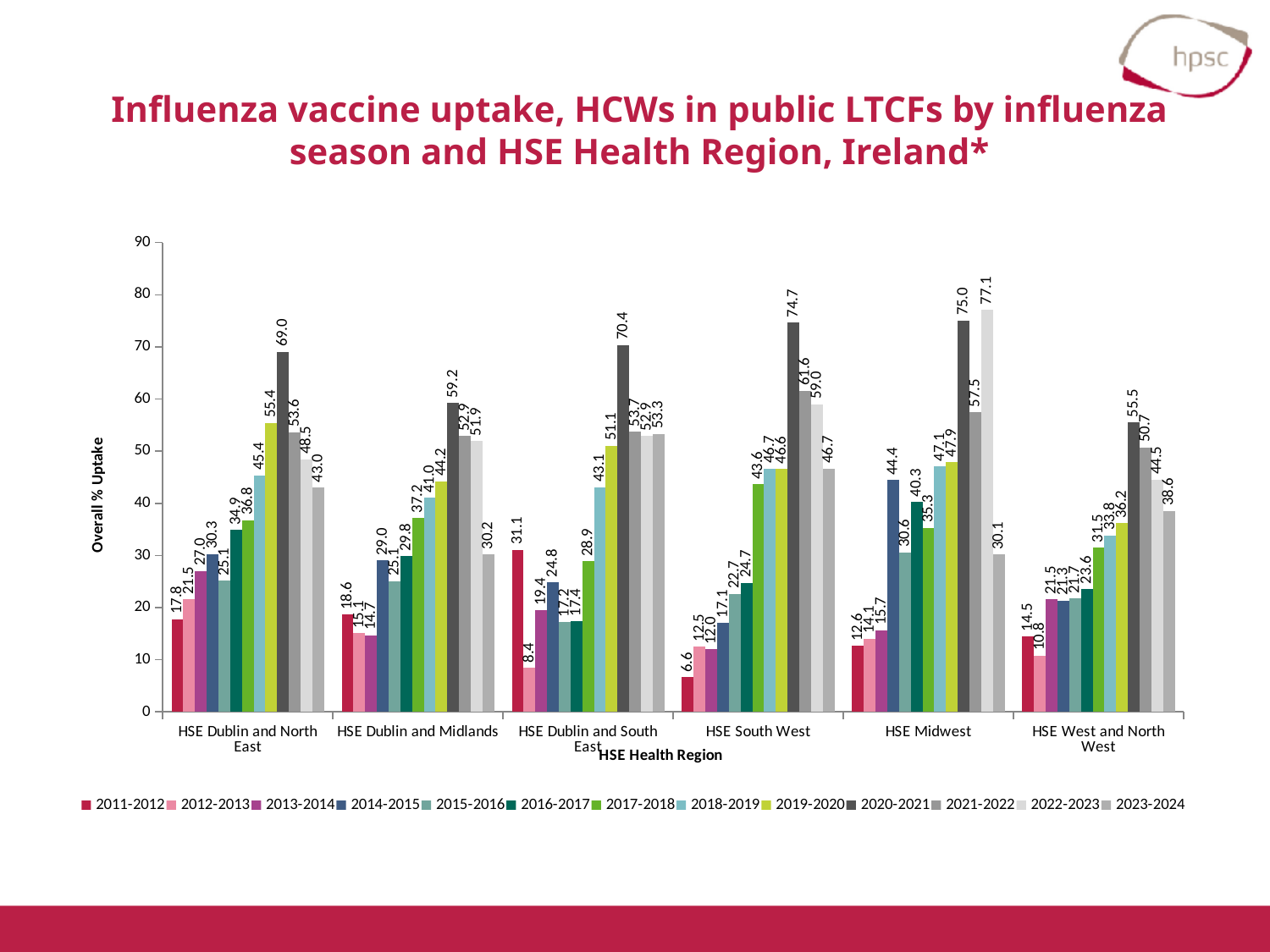
How many HSE Health Regions are shown on the x axis? 6 What is the label on the y axis of the chart? Overall % Uptake Which season has the lowest uptake value for HSE South West? 2011-2012 How many influenza seasons does the legend list? 13 What type of chart is shown on the slide? Bar chart What is the difference between the 2020-2021 and 2023-2024 uptake values for HSE Dublin and North East? 26.0 Is the 2020-2021 uptake value for HSE Dublin and Midlands greater or less than 50? greater Which HSE Health Region has the highest single-season uptake value on the chart? HSE Midwest What is the influenza vaccine uptake for HSE South West in the 2020-2021 season? 74.7 What is the value for HSE Dublin and South East in the 2011-2012 season? 31.1 For HSE Midwest, which season has the larger uptake: 2020-2021 or 2022-2023? 2022-2023 What is the 2023-2024 uptake value for HSE West and North West? 38.6